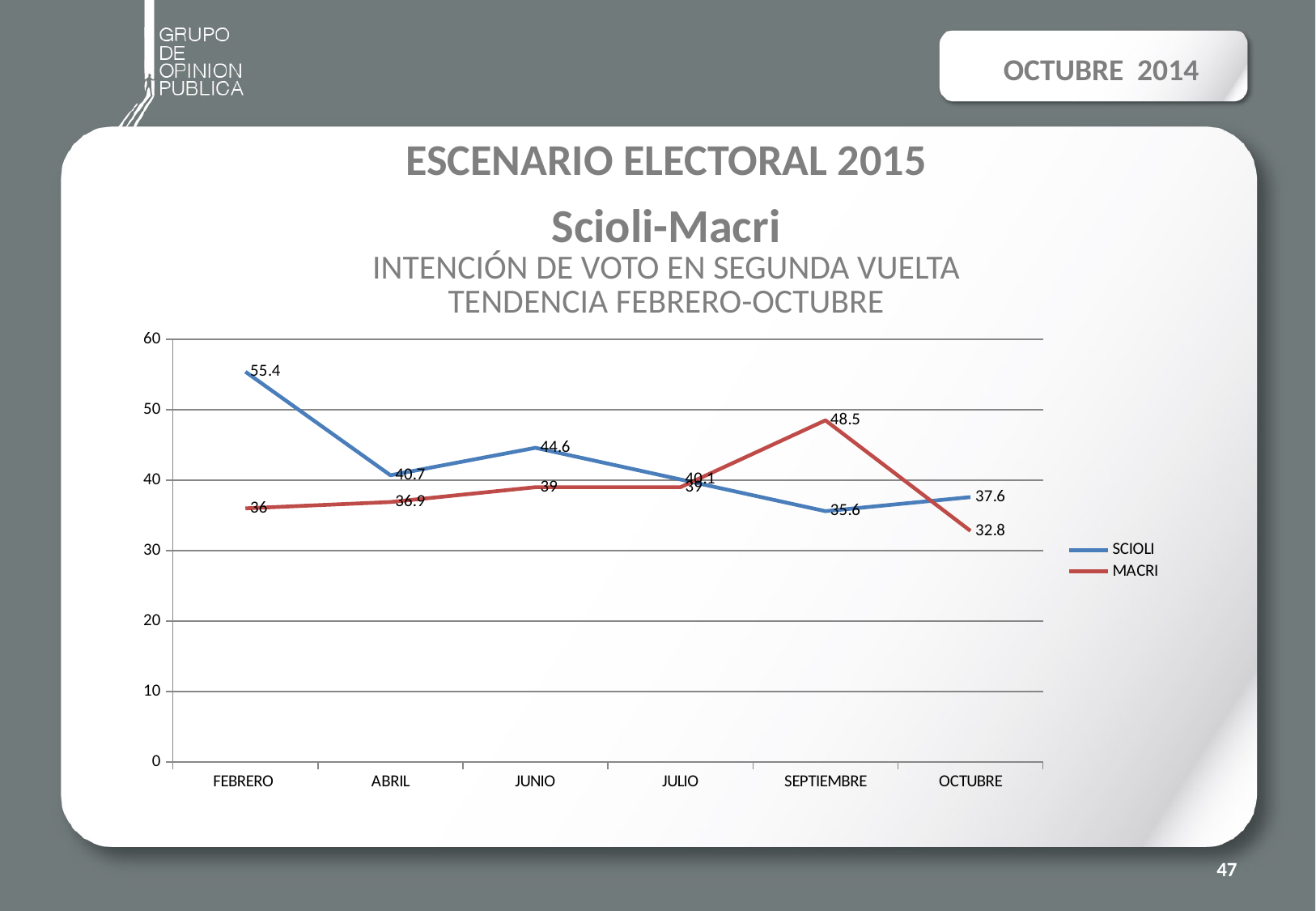
What is the value for SCIOLI in JUNIO? 44.6 How many series does the legend list? 2 What is the value for SCIOLI in FEBRERO? 55.4 Which series has the larger value in SEPTIEMBRE, SCIOLI or MACRI? MACRI Which series is drawn in red? MACRI What kind of chart is shown on the slide? line chart What is the value for MACRI in OCTUBRE? 32.8 In which month is the MACRI value lowest? OCTUBRE In which month is the SCIOLI value highest? FEBRERO How many months are shown on the x axis? 6 What is the difference between SCIOLI and MACRI in FEBRERO? 19.4 What is the value for MACRI in SEPTIEMBRE? 48.5